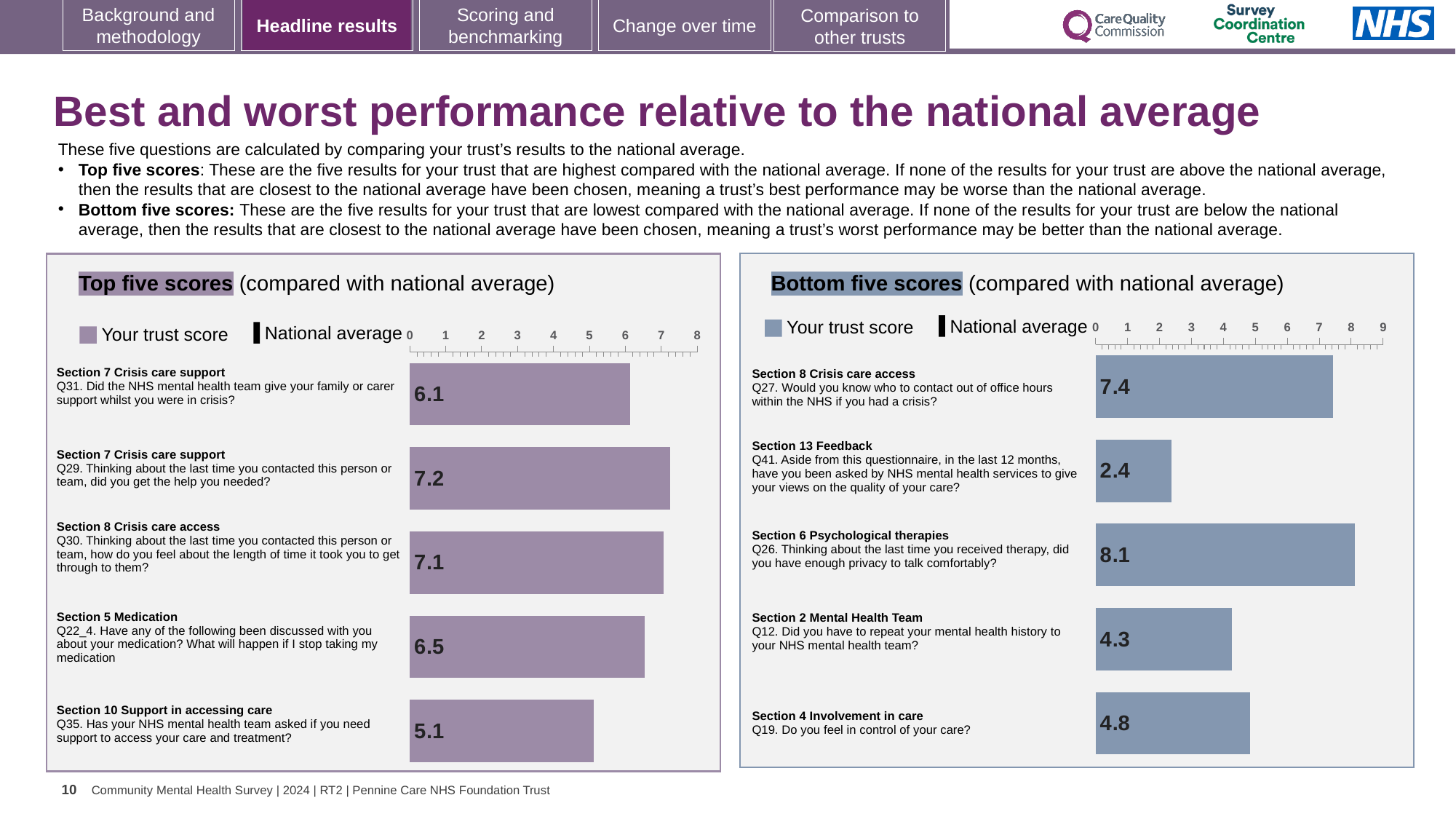
In the Top five scores chart, what is the trust score for Q35 (Has your NHS mental health team asked if you need support to access your care and treatment?)? 5.1 What kind of chart is the Bottom five scores chart? Bar chart In the Bottom five scores chart, which question has the lowest trust score? Q41 How many questions are plotted in the Top five scores chart? 5 In the Bottom five scores chart, which has the larger trust score, Q12 or Q19? Q19 In the Bottom five scores chart, what is the trust score for Q41 (have you been asked by NHS mental health services to give your views on the quality of your care?)? 2.4 In the Top five scores chart, what is the trust score for Q31 (Did the NHS mental health team give your family or carer support whilst you were in crisis?)? 6.1 In the Top five scores chart, which question has the highest trust score? Q29 In the Bottom five scores chart, what is the difference between the trust scores for Q26 and Q41? 5.7 In the Top five scores chart, what is the difference between the trust scores for Q29 and Q35? 2.1 In the Bottom five scores chart, which question has the highest trust score? Q26 In the Bottom five scores chart, what is the trust score for Q19 (Do you feel in control of your care?)? 4.8